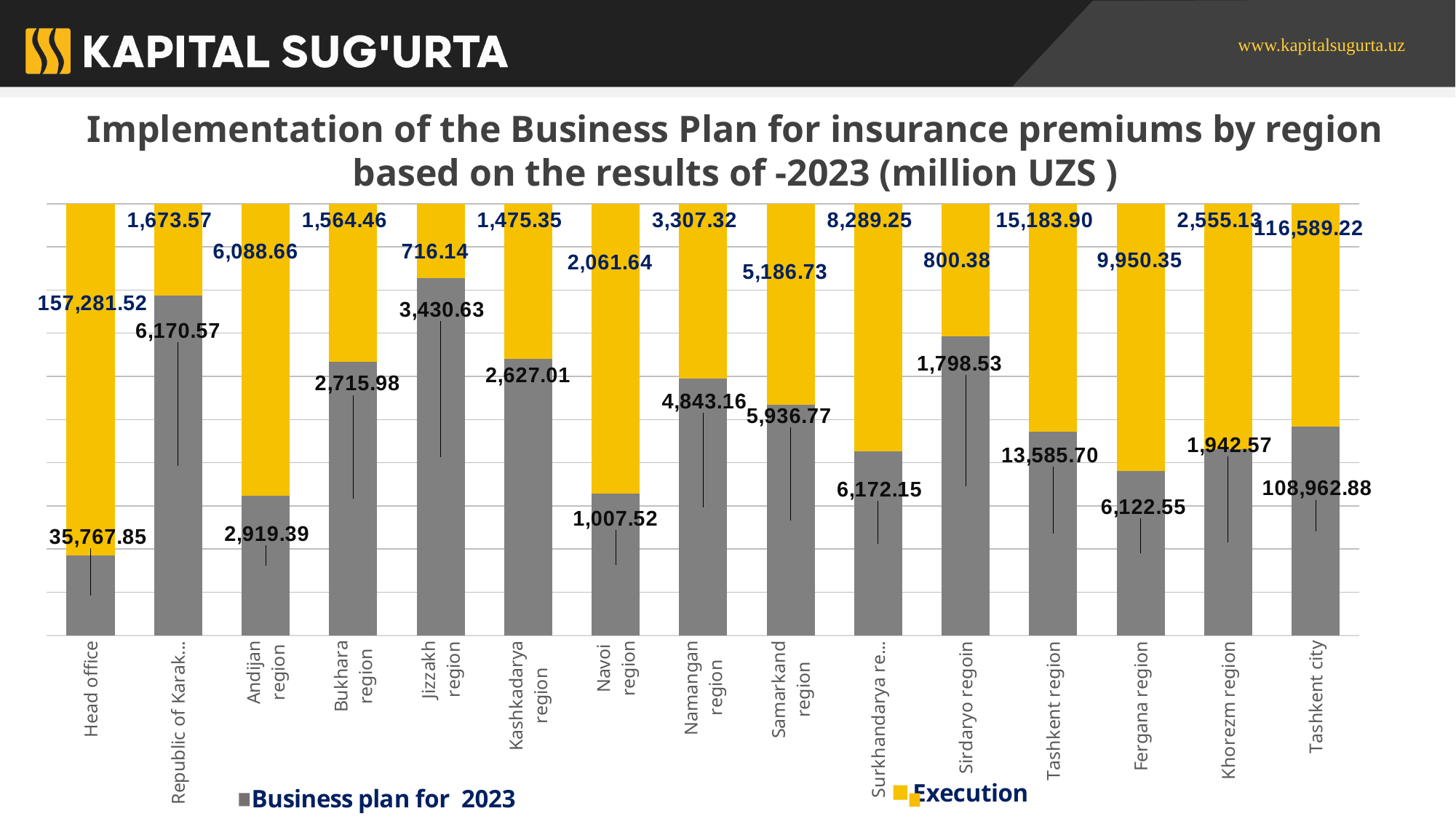
What is the Execution value for Fergana region? 9,950.35 Which category has the highest Execution value? Head office How many regions/categories are shown on the x axis? 15 For Samarkand region, which is larger: the Business plan for 2023 value or the Execution value? Business plan for 2023 What kind of chart is shown on the slide? Stacked bar chart What is the Execution value for Head office? 157,281.52 Which category has the highest Business plan for 2023 value? Tashkent city How many series does the legend list? 2 What is the difference between the Execution and Business plan for 2023 values for Tashkent region? 1,598.20 What is the Business plan for 2023 value for Navoi region? 1,007.52 Which region has the lowest Execution value? Jizzakh region What is the Business plan for 2023 value for Tashkent city? 108,962.88